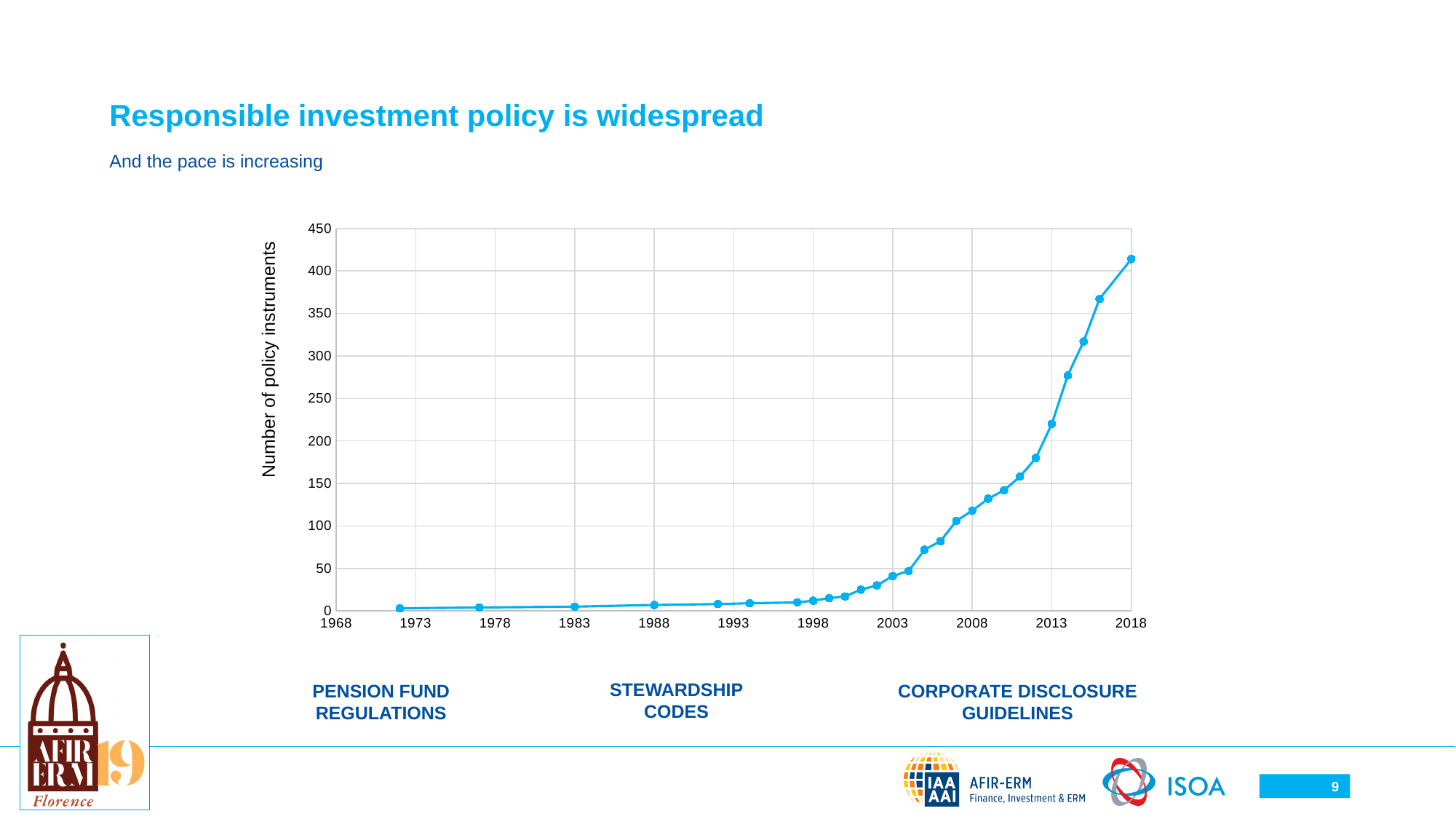
Which year has the larger number of policy instruments, 2003 or 2008? 2008 Do the values in the chart rise or fall as the years increase along the x axis? rise What is the highest value shown on the y axis of the chart? 450 Is the value for 2008 greater or less than 150? less Which year has the larger number of policy instruments, 2013 or 2018? 2018 Is the value for 1998 greater or less than 50? less Is the value for 2003 greater or less than 50? less What kind of chart is shown on the slide? line chart Which year on the x axis has the highest number of policy instruments? 2018 What is the label on the y axis of the chart? Number of policy instruments